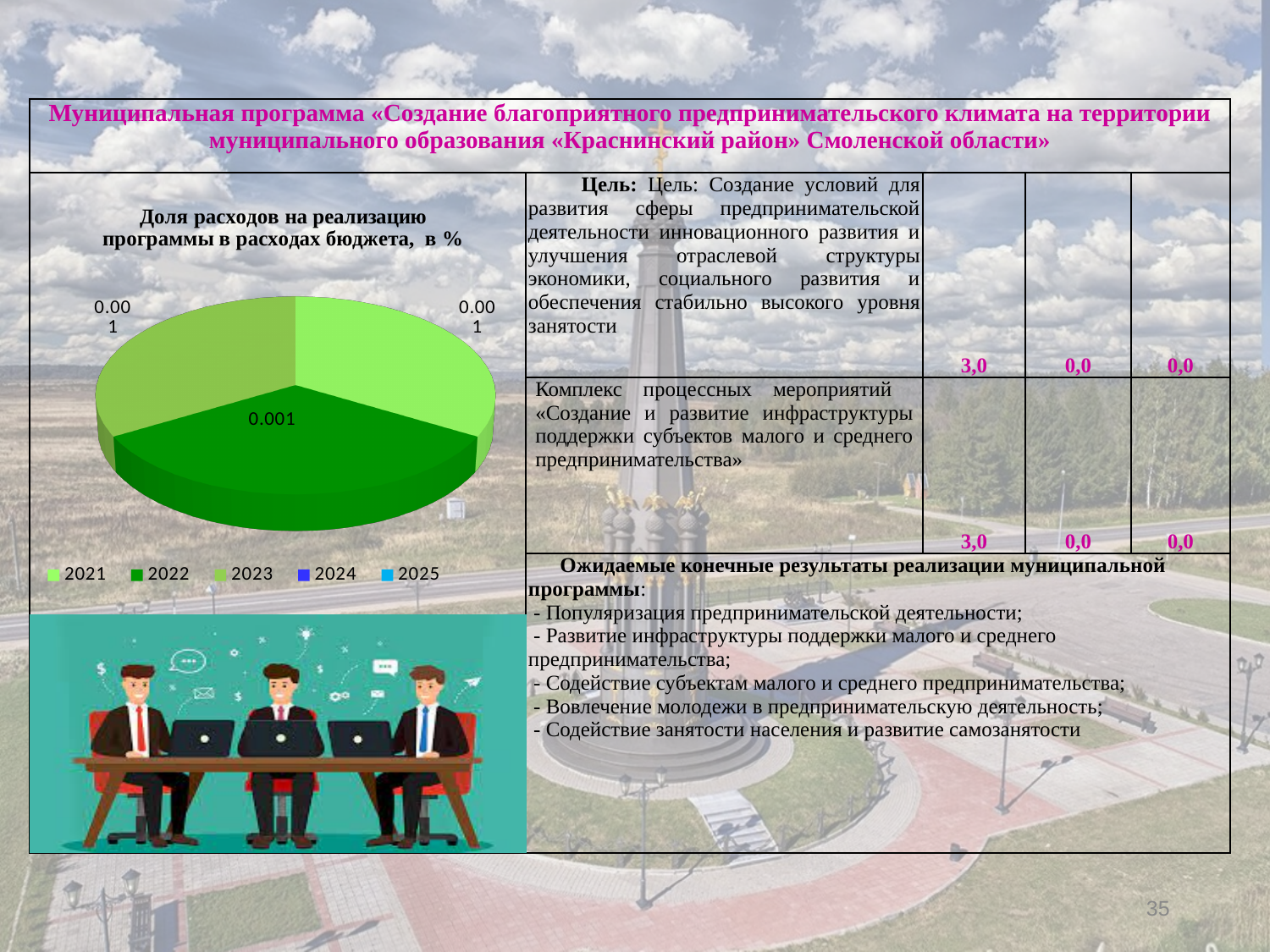
What value is printed on the top-left slice of the pie chart? 0.001 How many entries does the legend of the pie chart list? 5 Is the value printed on the dark green slice of the pie chart greater or less than 1? less What is the title of the pie chart? Доля расходов на реализацию программы в расходах бюджета, в % What kind of chart is shown on the left of the slide? pie chart What value is printed on the dark green slice of the pie chart? 0.001 How many slices are visible in the pie chart? 3 Which years are listed in the legend of the pie chart? 2021, 2022, 2023, 2024, 2025 What value is printed on the top-right slice of the pie chart? 0.001 Are the three labelled slices of the pie chart equal in value? yes